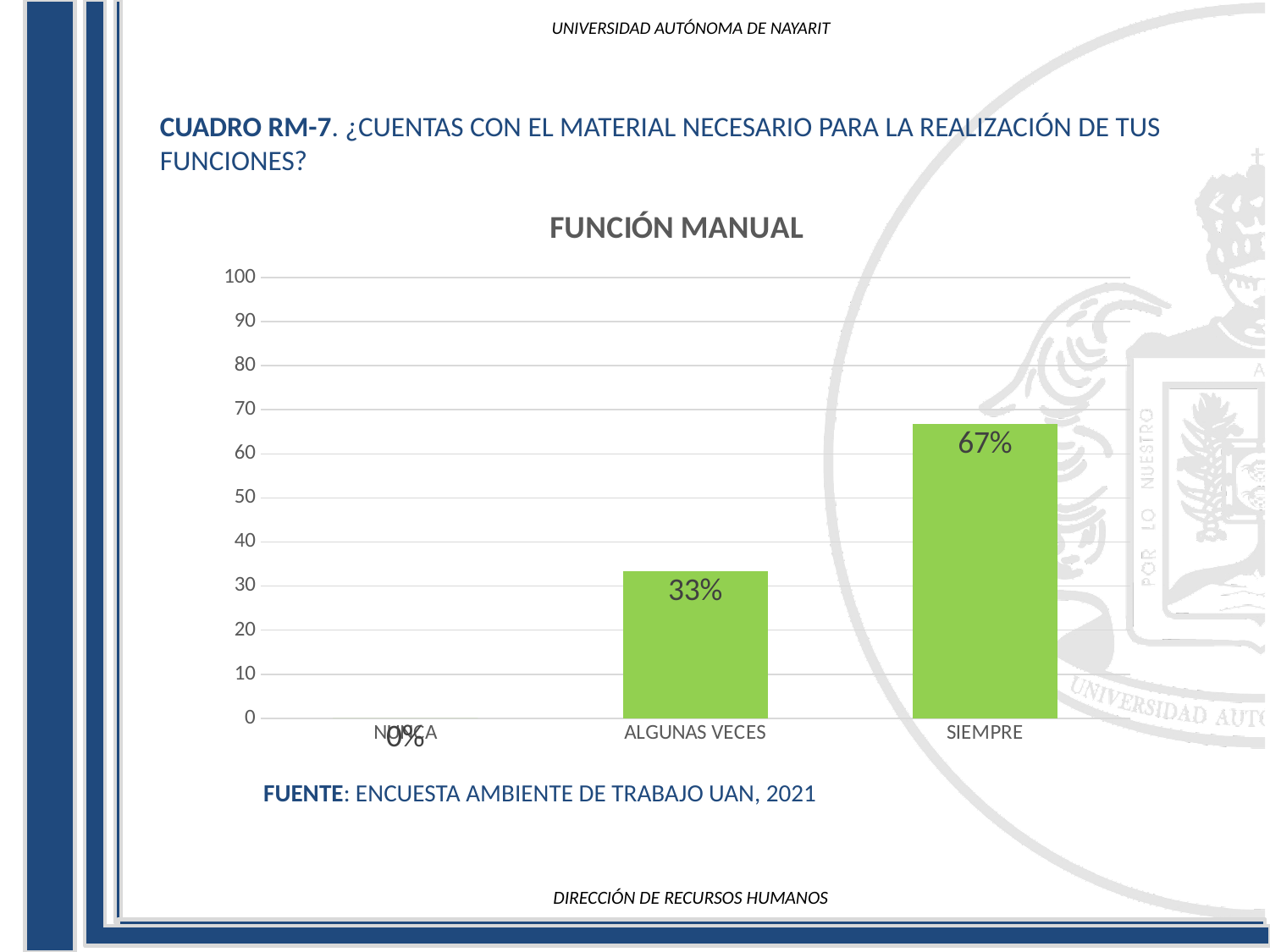
What is the value for NUNCA? 0% Which is larger, the value for ALGUNAS VECES or the value for SIEMPRE? SIEMPRE How many categories are shown on the x axis? 3 Is the value for ALGUNAS VECES greater or less than 40? less What is the difference between the values for SIEMPRE and ALGUNAS VECES? 34% What is the value for SIEMPRE? 67% What is the value for ALGUNAS VECES? 33% Which category has the highest value? SIEMPRE Which category has the lowest value? NUNCA What is the title of the chart? FUNCIÓN MANUAL Is the value for SIEMPRE greater or less than 50? greater What kind of chart is shown? bar chart